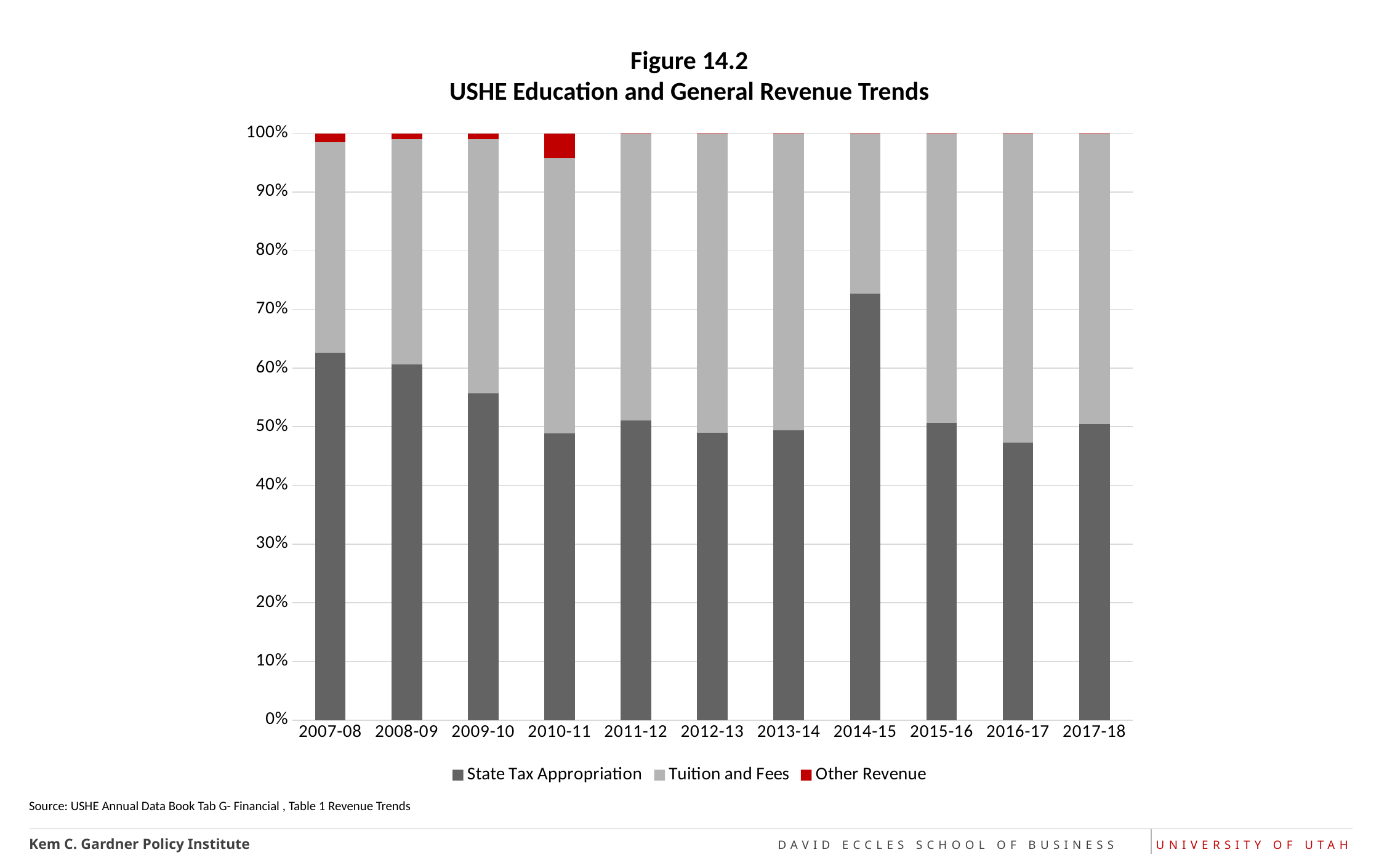
Which series is shown in red in the legend? Other Revenue Is the State Tax Appropriation share for 2016-17 greater or less than 50%? less Is the State Tax Appropriation share for 2014-15 greater or less than 70%? greater In which year is the State Tax Appropriation share the lowest? 2016-17 In which year is the State Tax Appropriation share the highest? 2014-15 Does the State Tax Appropriation share rise or fall from 2007-08 to 2010-11? fall How many series does the legend list? 3 How many fiscal years are shown along the x axis? 11 What kind of chart is shown on the slide? Stacked bar chart Is the State Tax Appropriation share for 2007-08 greater or less than 60%? greater In which year is the Other Revenue share the largest? 2010-11 Which year has a larger State Tax Appropriation share, 2007-08 or 2008-09? 2007-08